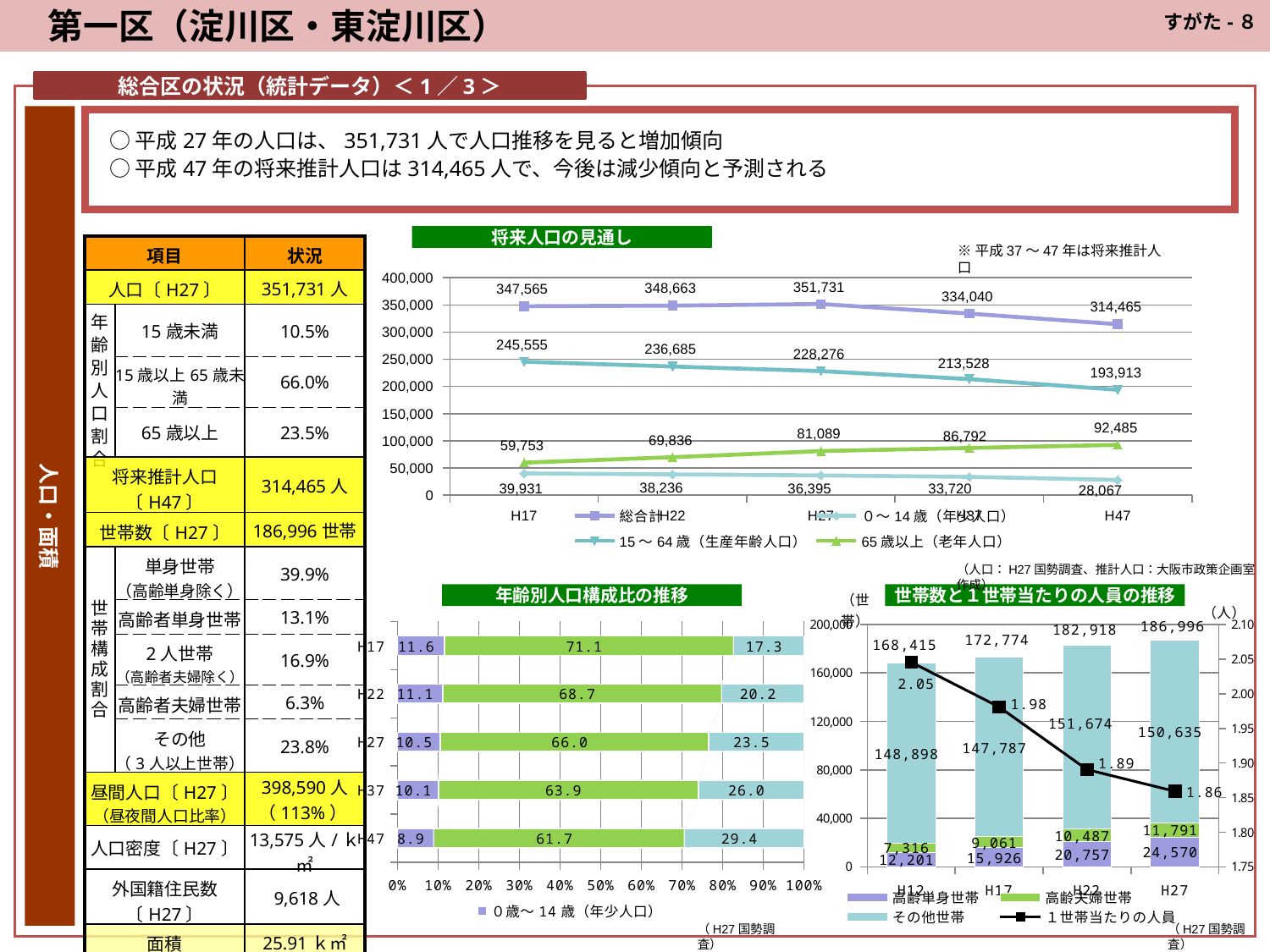
In the 世帯数と１世帯当たりの人員の推移 chart, what is the 1世帯当たりの人員 value for H22? 1.89 In the 将来人口の見通し chart, what is the 総合計 value for H27? 351,731 In the 将来人口の見通し chart, does the 15～64歳（生産年齢人口） series rise or fall from H17 to H47? fall In the 将来人口の見通し chart, what is the 65歳以上（老年人口） value for H47? 92,485 In the 世帯数と１世帯当たりの人員の推移 chart, which is larger for H17: 高齢単身世帯 or 高齢夫婦世帯? 高齢単身世帯 What kind of chart is the 年齢別人口構成比の推移 chart? stacked bar chart In the 将来人口の見通し chart, which year has the highest 総合計 value? H27 In the 年齢別人口構成比の推移 chart, which year has the lowest value for the 0歳～14歳 segment? H47 In the 将来人口の見通し chart, how many series does the legend list? 4 In the 将来人口の見通し chart, what is the difference between the 総合計 values for H27 and H47? 37,266 In the 世帯数と１世帯当たりの人員の推移 chart, what is the total number of households shown for H27? 186,996 In the 年齢別人口構成比の推移 chart, what is the value of the middle (15～64歳) segment for H27? 66.0